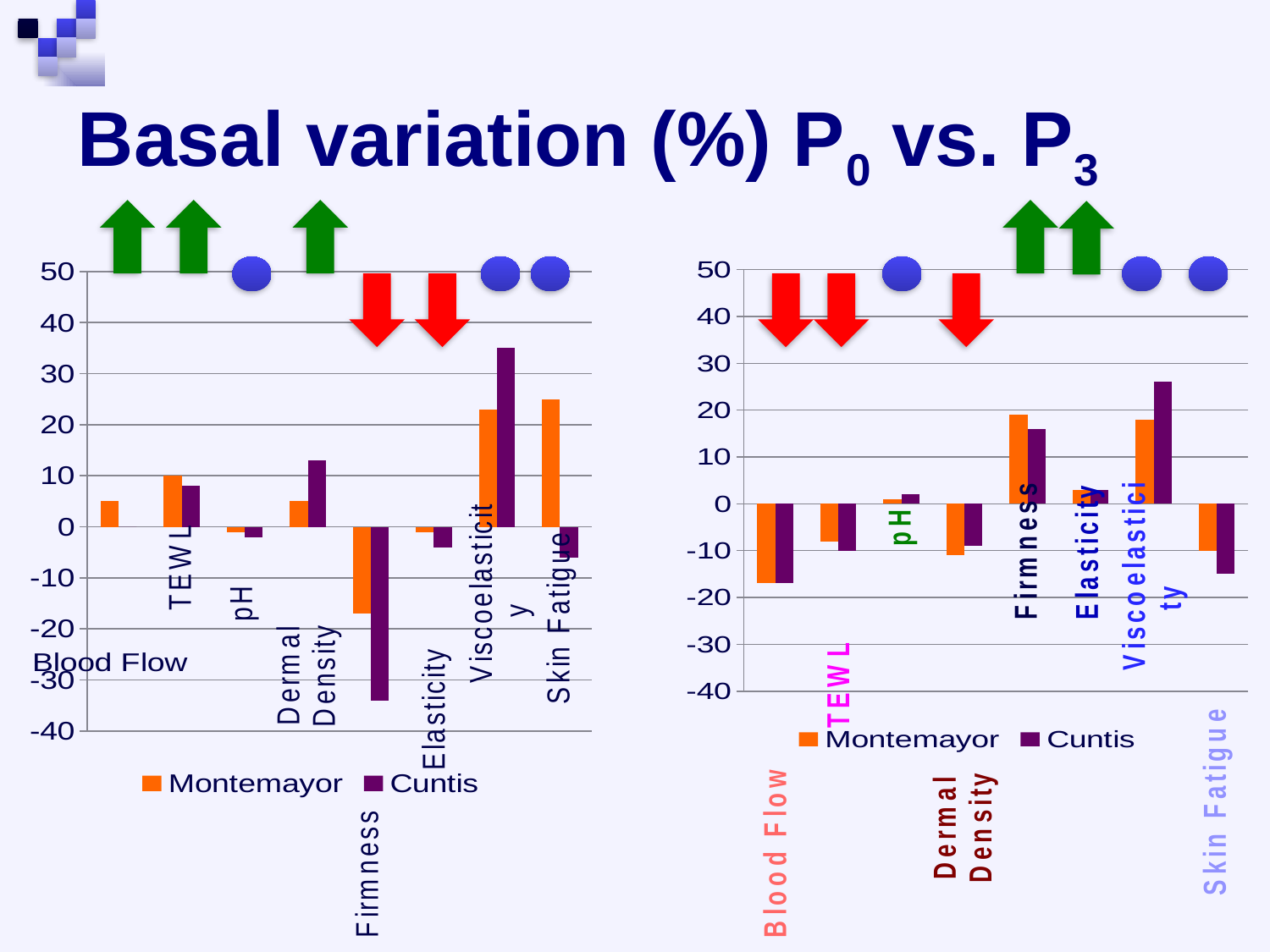
How many categories are plotted on the left chart? 8 How many series does the legend of the right chart list? 2 On the left chart, which category has the highest Cuntis value? Viscoelasticity On the left chart, which category has the lowest Montemayor value? Firmness On the left chart, is the Cuntis value for Firmness greater or less than -30? less On the right chart, is the Montemayor value for Blood Flow greater or less than -10? less On the left chart, is the Cuntis value for Viscoelasticity greater or less than 30? greater On the left chart, which category has the lowest Cuntis value? Firmness On the right chart, which colour represents the Montemayor series? orange On the left chart, for Dermal Density, which series has the larger value, Montemayor or Cuntis? Cuntis On the right chart, which category has the highest Cuntis value? Viscoelasticity What kind of chart is the left chart on the slide? bar chart